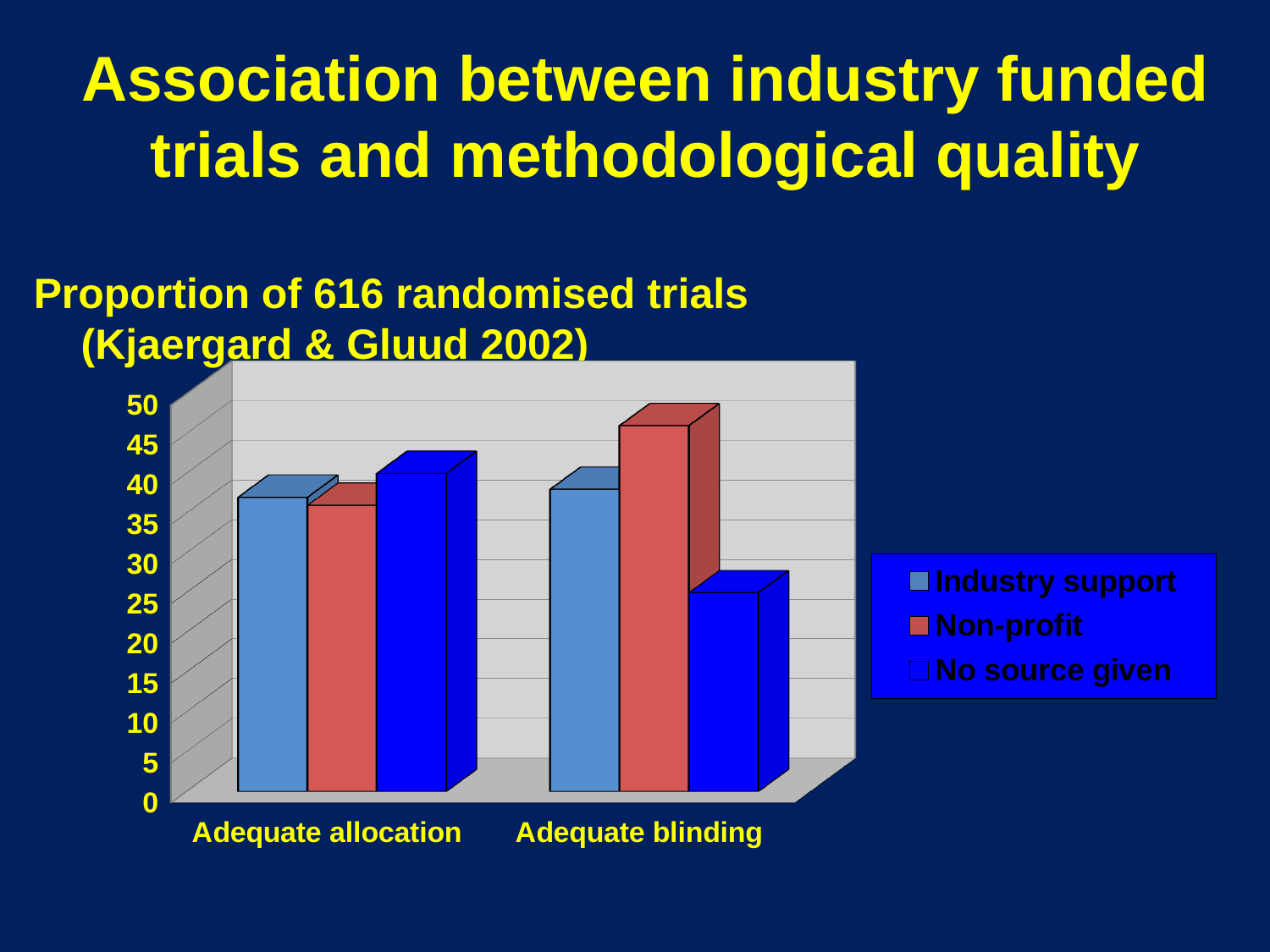
How many categories are shown on the x axis of the chart? 2 Is the value for Non-profit in Adequate blinding greater or less than 40? greater Which series has the highest value for Adequate blinding? Non-profit Is the value for No source given in Adequate blinding greater or less than 30? less What kind of chart is shown on the slide? bar chart Which series has the highest value for Adequate allocation? No source given What are the three series listed in the chart's legend? Industry support, Non-profit, No source given For Adequate blinding, which is larger: Non-profit or No source given? Non-profit Is the value for Industry support in Adequate allocation greater or less than 30? greater For Adequate allocation, which is larger: No source given or Non-profit? No source given How many series does the chart's legend list? 3 Which series has the lowest value for Adequate blinding? No source given